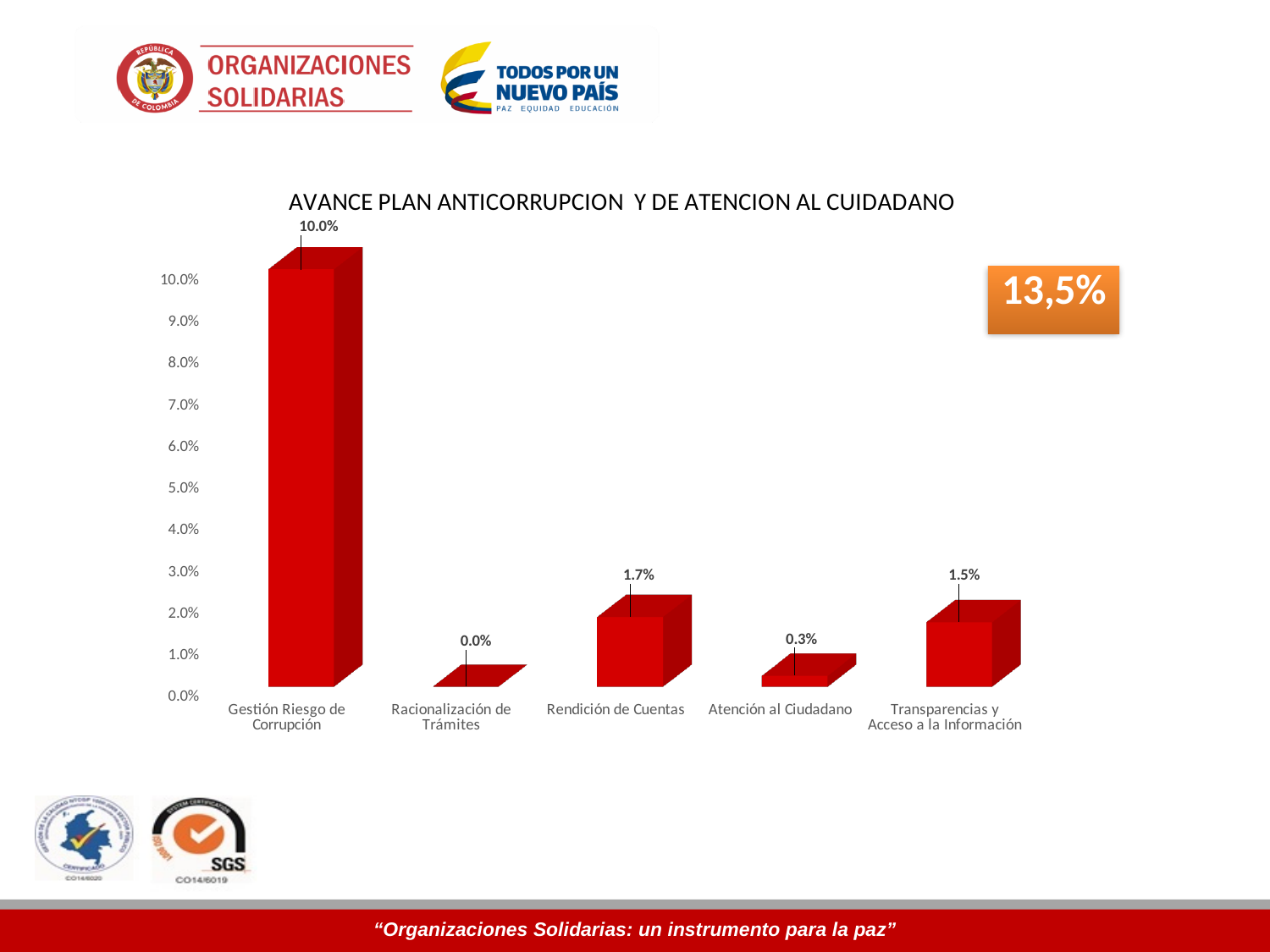
Which category has the highest value? Gestión Riesgo de Corrupción What is the title of the chart? AVANCE PLAN ANTICORRUPCION Y DE ATENCION AL CUIDADANO What is the value for Transparencias y Acceso a la Información? 1.5% What is the value for Racionalización de Trámites? 0.0% What is the value for Atención al Ciudadano? 0.3% How many categories are shown on the x axis? 5 What is the value for Rendición de Cuentas? 1.7% Which category has the lowest value? Racionalización de Trámites What kind of chart is shown on the slide? Bar chart Which is larger, the value for Rendición de Cuentas or the value for Transparencias y Acceso a la Información? Rendición de Cuentas What is the value for Gestión Riesgo de Corrupción? 10.0% What is the difference between the values for Gestión Riesgo de Corrupción and Rendición de Cuentas? 8.3%